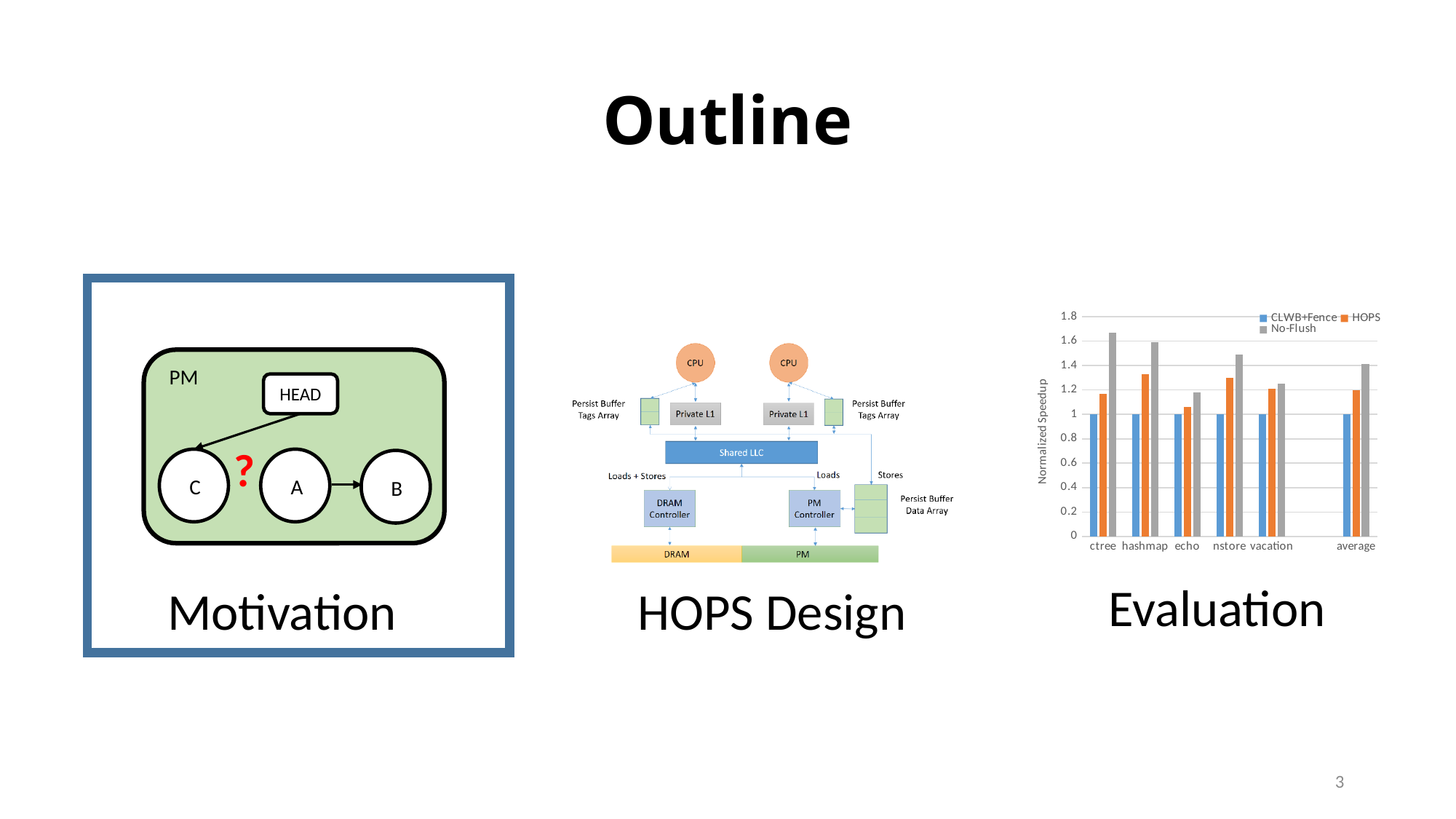
What is the y-axis title of the Evaluation chart? Normalized Speedup What kind of chart is shown under the Evaluation heading? bar chart In the Evaluation chart, which category has the lowest HOPS value? echo How many categories are shown on the x axis of the Evaluation chart? 6 In the Evaluation chart, is the HOPS value for echo greater or less than 1.2? less In the Evaluation chart, is the No-Flush value for nstore greater or less than 1.4? greater In the Evaluation chart, which is larger: the HOPS value for hashmap or the HOPS value for echo? hashmap In the Evaluation chart, which is larger for ctree: the HOPS value or the No-Flush value? No-Flush In the Evaluation chart, which category has the highest No-Flush value? ctree In the Evaluation chart, is the No-Flush value for ctree greater or less than 1.6? greater In the Evaluation chart, what is the value of CLWB+Fence for ctree? 1 How many series does the legend of the Evaluation chart list? 3